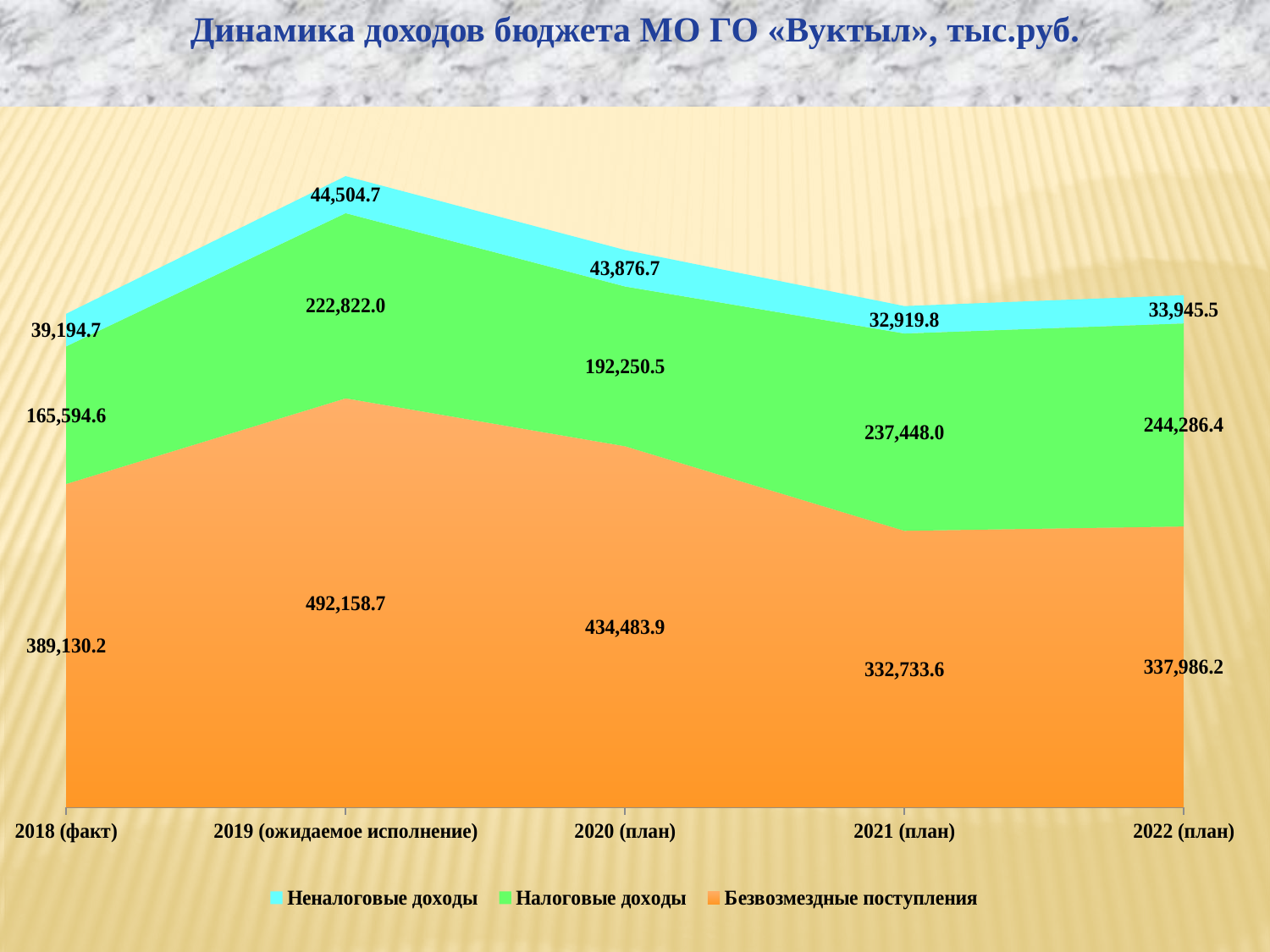
What is the value of Неналоговые доходы for 2018 (факт)? 39,194.7 What is the value of Налоговые доходы for 2020 (план)? 192,250.5 In which year is Безвозмездные поступления highest? 2019 (ожидаемое исполнение) Do the values of Безвозмездные поступления rise or fall from 2019 (ожидаемое исполнение) to 2021 (план)? Fall Which is larger: Налоговые доходы in 2021 (план) or in 2022 (план)? 2022 (план) How many series does the legend list? 3 What is the value of Безвозмездные поступления for 2019 (ожидаемое исполнение)? 492,158.7 In which year is Неналоговые доходы lowest? 2021 (план) What type of chart is shown on the slide? Area chart What is the difference between Безвозмездные поступления in 2019 (ожидаемое исполнение) and 2018 (факт)? 103,028.5 How many categories are shown on the x axis? 5 What is the total of all three series for 2018 (факт)? 593,919.5